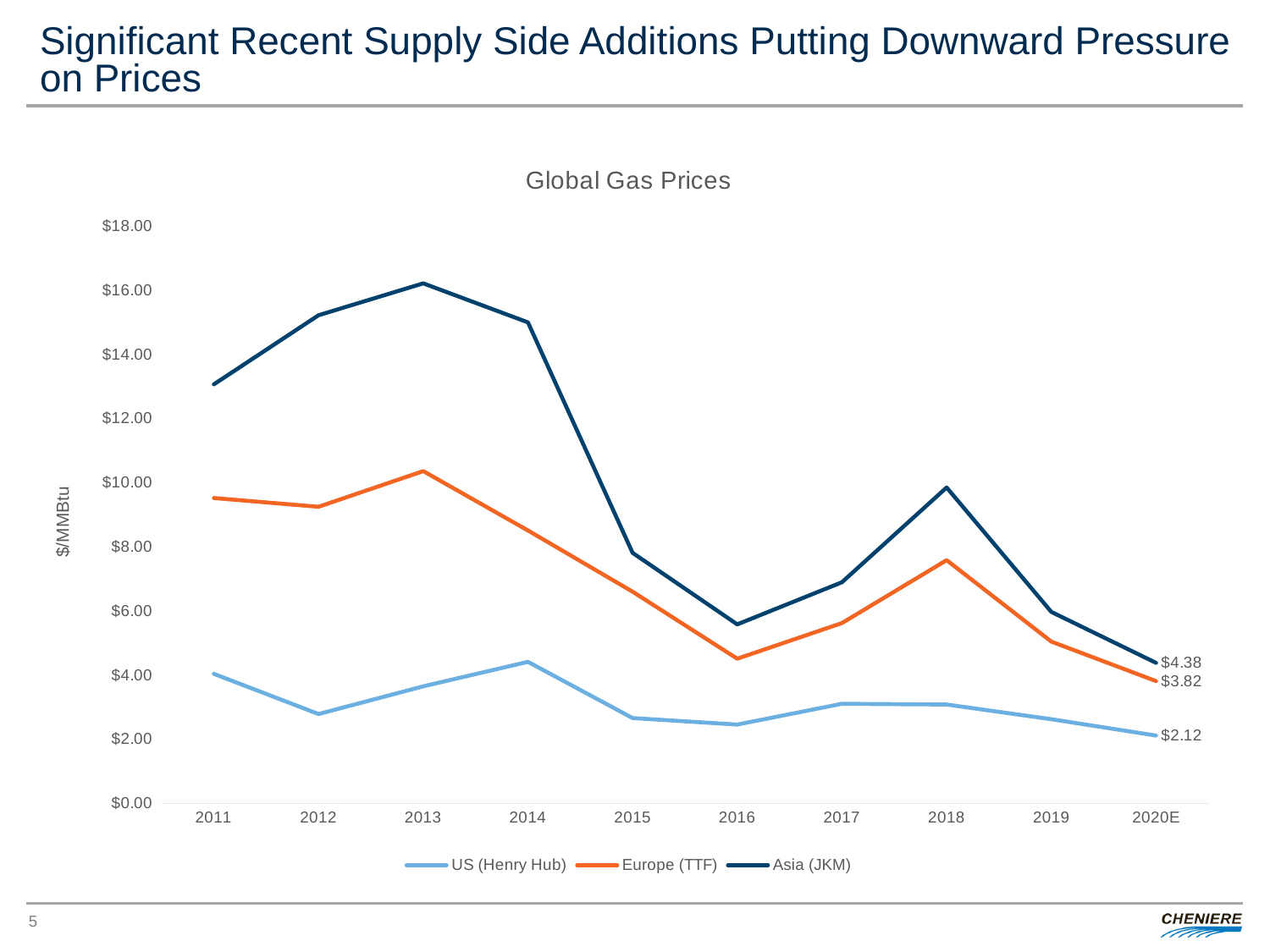
What is the Europe (TTF) price in 2020E? $3.82 What is the difference between the Asia (JKM) and Europe (TTF) prices in 2020E? $0.56 What is the Asia (JKM) price in 2020E? $4.38 Is the Asia (JKM) value for 2013 greater or less than $16.00? greater What type of chart is shown on the slide? line chart In which year does the Asia (JKM) series reach its highest value? 2013 What is the unit shown on the y axis? $/MMBtu How many series does the legend list? 3 Which series is higher in 2018, Europe (TTF) or US (Henry Hub)? Europe (TTF) What is the US (Henry Hub) price in 2020E? $2.12 How many years are shown on the x axis? 10 What is the chart title? Global Gas Prices